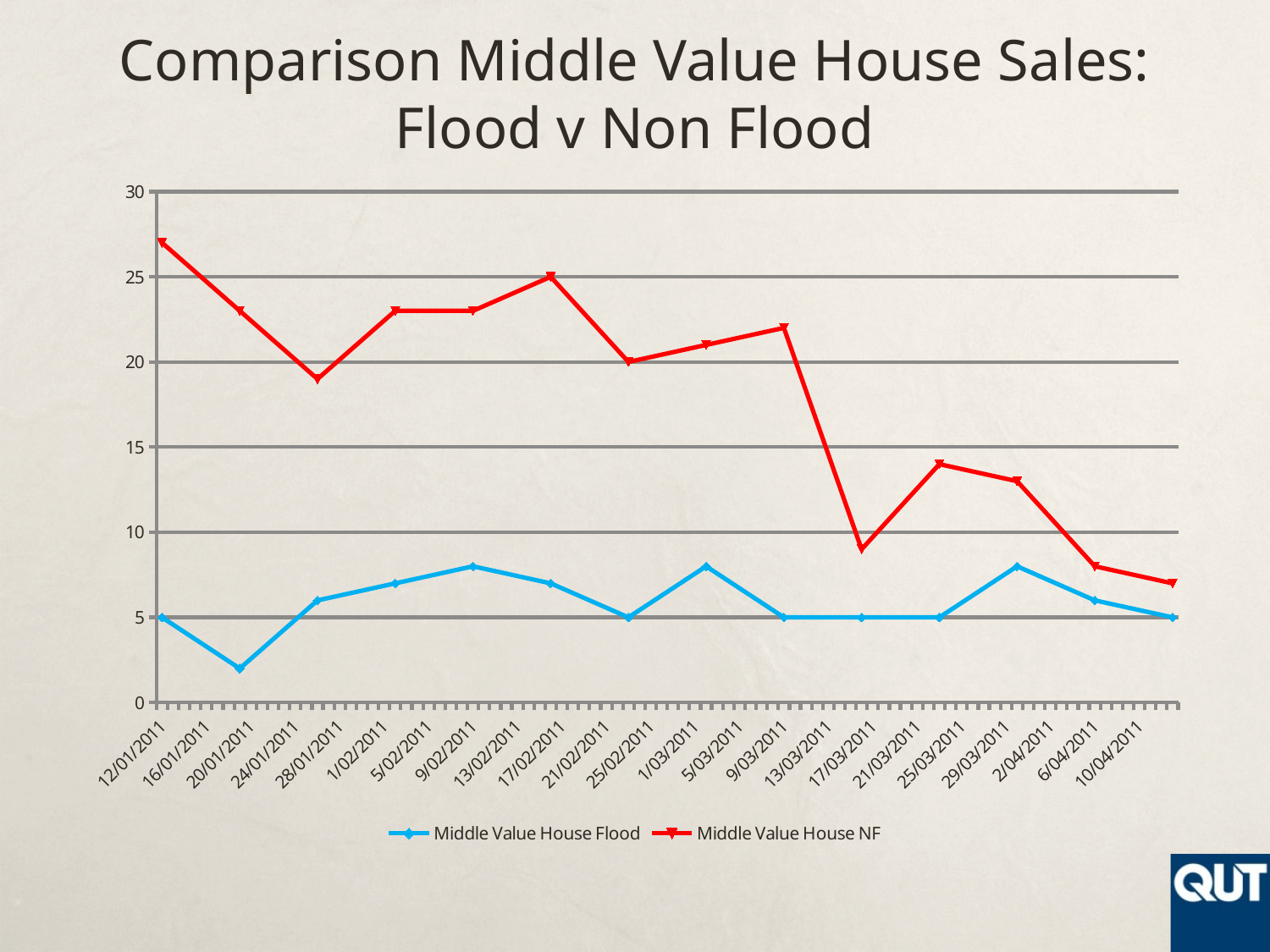
Is the value of Middle Value House NF on 12/01/2011 greater or less than 25? greater Is the value of Middle Value House NF on 10/04/2011 greater or less than 10? less What is the value of Middle Value House Flood on 10/04/2011? 5 What kind of chart is shown on the slide? line chart Does the Middle Value House NF series generally rise or fall from left to right? fall What is the value of Middle Value House Flood on 12/01/2011? 5 On 12/01/2011, which series has the higher value, Middle Value House Flood or Middle Value House NF? Middle Value House NF What is the title of the chart? Comparison Middle Value House Sales: Flood v Non Flood How many data points does each series have? 14 On which date does the Middle Value House NF series reach its highest value? 12/01/2011 Which series is drawn in red? Middle Value House NF How many series does the legend list? 2